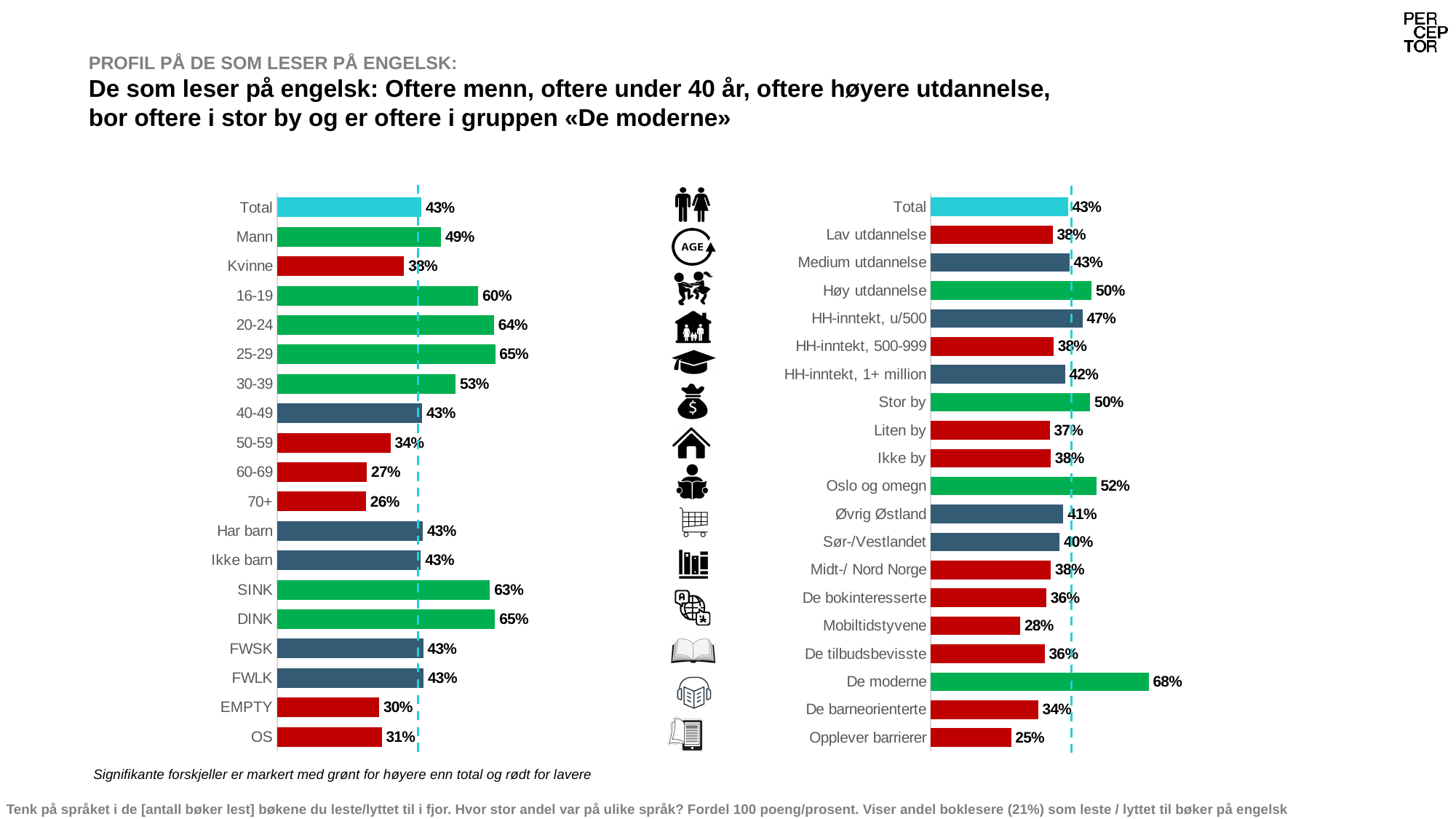
In the left chart, what is the value for Mann? 49% In the left chart, which category has the lowest value? 70+ In the left chart, what is the difference between the values for 25-29 and 60-69? 38 percentage points What type of chart is the left chart? Bar chart In the left chart, which is larger, the value for SINK or the value for 30-39? SINK In the left chart, what is the value for 20-24? 64% In the right chart, what is the value for Mobiltidstyvene? 28% In the right chart, which category has the lowest value? Opplever barrierer In the right chart, what is the value for Oslo og omegn? 52% In the right chart, what is the difference between the values for De moderne and Total? 25 percentage points How many categories are shown in the right chart? 20 In the right chart, which category has the highest value? De moderne